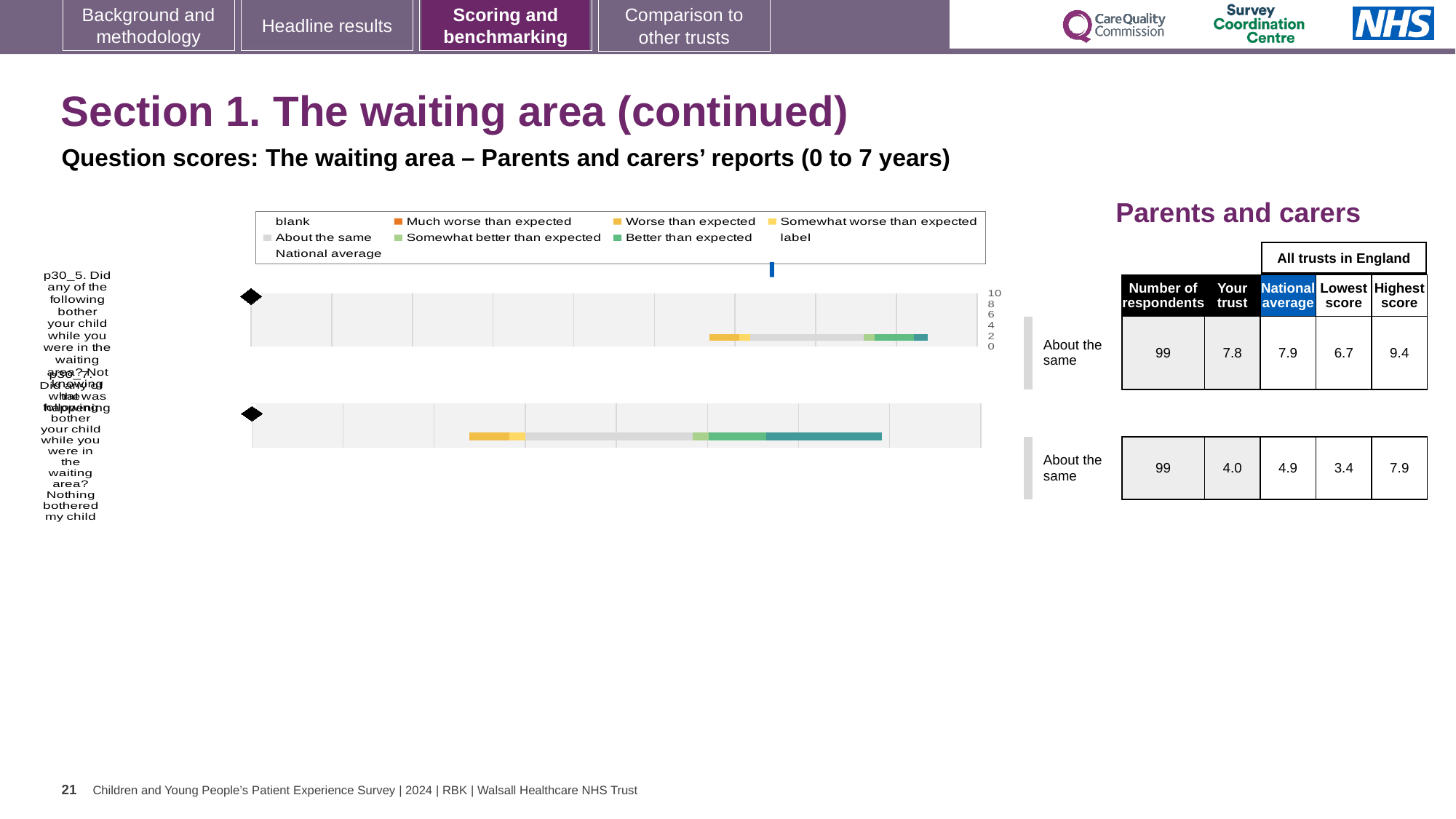
What kind of chart is shown on the slide? bar chart Which legend entry is shown in orange? Much worse than expected How many entries does the chart legend list? 9 In the table next to the chart, what is the lowest score for the second question (p30_7)? 3.4 How many bars (questions) are plotted in the chart? 2 In the table next to the chart, what is the 'Your trust' score for the first question (p30_5)? 7.8 In the table next to the chart, what is the number of respondents for the first question (p30_5)? 99 Which legend entry is shown in grey? About the same In the table next to the chart, what is the national average for the second question (p30_7)? 4.9 For the second question (p30_7), which is larger: the 'Your trust' score or the national average? National average What benchmark category is shown beside both bars of the chart? About the same In the table next to the chart, what is the difference between the highest score and the lowest score for the first question (p30_5)? 2.7